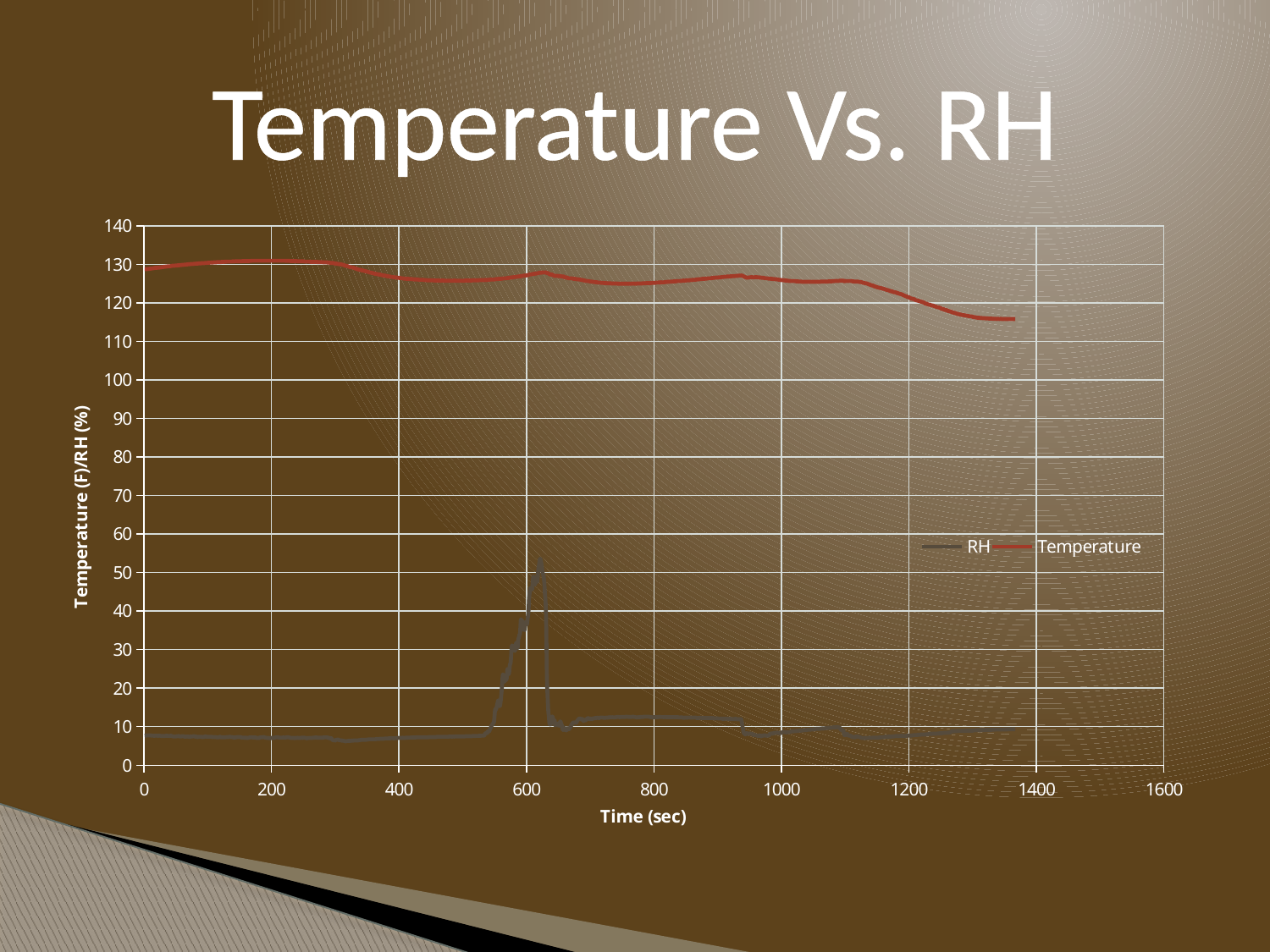
What kind of chart is shown on the slide? line chart How many series does the legend list? 2 Is the RH value at 800 sec greater or less than 20? less Is the RH value at 200 sec greater or less than 10? less What is the title of the chart? Temperature Vs. RH Near which x-axis tick does the RH line spike sharply? 600 Is the Temperature value at time 0 greater or less than 120? greater Does the Temperature line overall rise or fall from the start to the end of the time axis? fall Which series has the larger value at 400 sec, RH or Temperature? Temperature What is the label of the x axis? Time (sec)